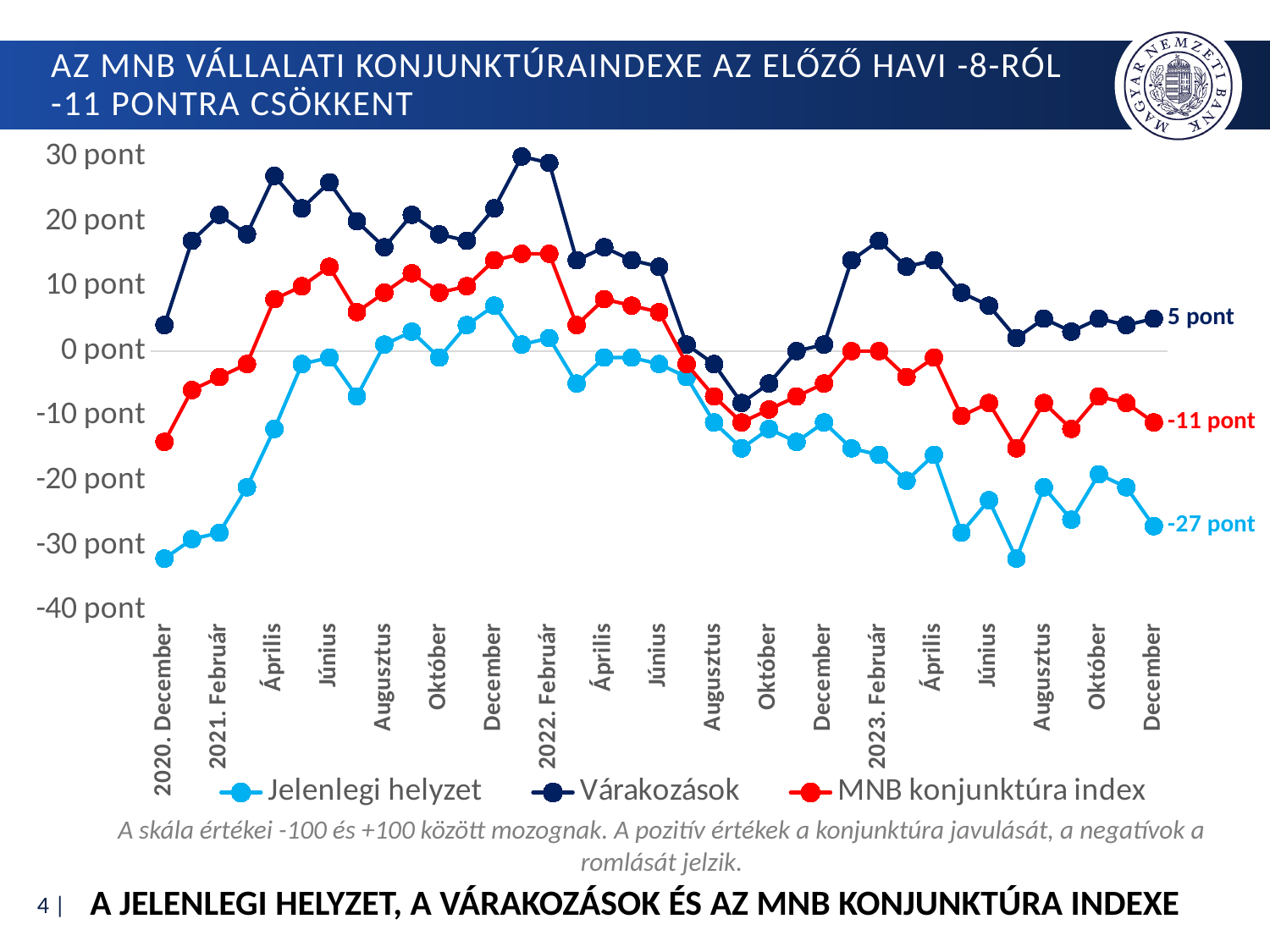
What is the difference between the Várakozások value and the Jelenlegi helyzet value in December 2023? 32 pont What is the value of the MNB konjunktúra index in December 2023? -11 pont Is the value of the Várakozások series in 2022. Február greater or less than 20 pont? greater How many series does the legend list? 3 What is the value of the Jelenlegi helyzet series in December 2023? -27 pont What is the value of the Várakozások series in December 2023? 5 pont Which series has the highest value in December 2023? Várakozások What colour is the MNB konjunktúra index line? red What kind of chart is shown on the slide? line chart What is the difference between the Várakozások value and the MNB konjunktúra index value in December 2023? 16 pont Is the value of the Jelenlegi helyzet series in 2020. December greater or less than -20 pont? less Does the Jelenlegi helyzet series rise or fall between 2020. December and 2021 Június? rises